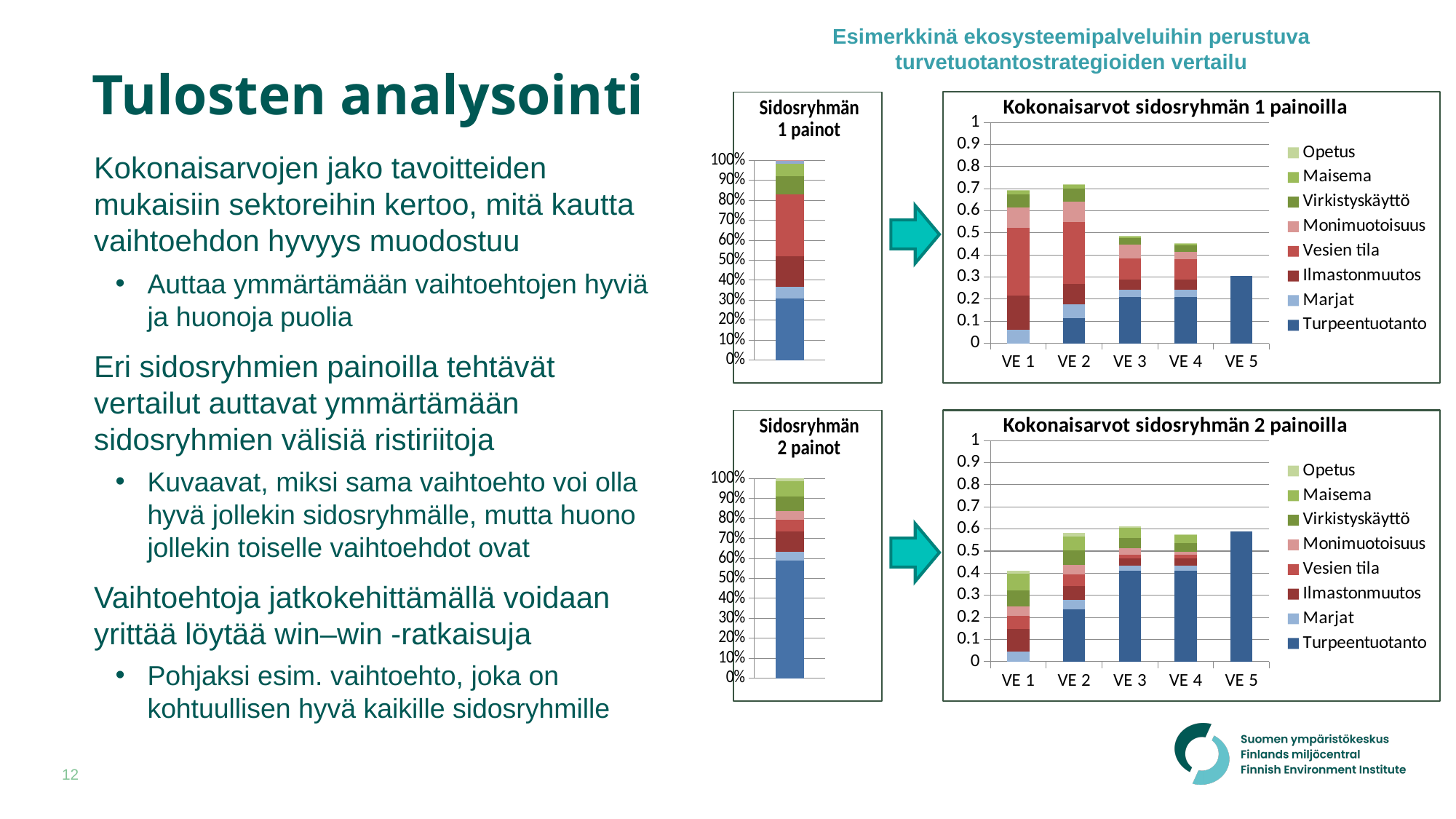
In the chart "Kokonaisarvot sidosryhmän 1 painoilla", which alternative has the highest total value? VE 2 In the chart "Kokonaisarvot sidosryhmän 1 painoilla", which alternative has the lowest total value? VE 5 In the chart "Sidosryhmän 2 painot", is the Turpeentuotanto share greater or less than 50%? greater In the chart "Kokonaisarvot sidosryhmän 2 painoilla", which alternative has the lowest total value? VE 1 In the chart "Kokonaisarvot sidosryhmän 2 painoilla", which has the larger total value, VE 1 or VE 3? VE 3 In the chart "Kokonaisarvot sidosryhmän 2 painoilla", is the total value for VE 5 greater or less than 0.5? greater In the chart "Kokonaisarvot sidosryhmän 1 painoilla", do the total values rise or fall from VE 2 to VE 5? fall In the chart "Kokonaisarvot sidosryhmän 1 painoilla", how many categories (VE alternatives) are shown on the x axis? 5 How many series does the legend of "Kokonaisarvot sidosryhmän 2 painoilla" list? 8 What kind of chart is "Kokonaisarvot sidosryhmän 1 painoilla"? Stacked bar chart In the chart "Kokonaisarvot sidosryhmän 1 painoilla", is the total value for VE 5 greater or less than 0.4? less In the chart "Kokonaisarvot sidosryhmän 1 painoilla", which series is listed last (at the bottom) in the legend? Turpeentuotanto